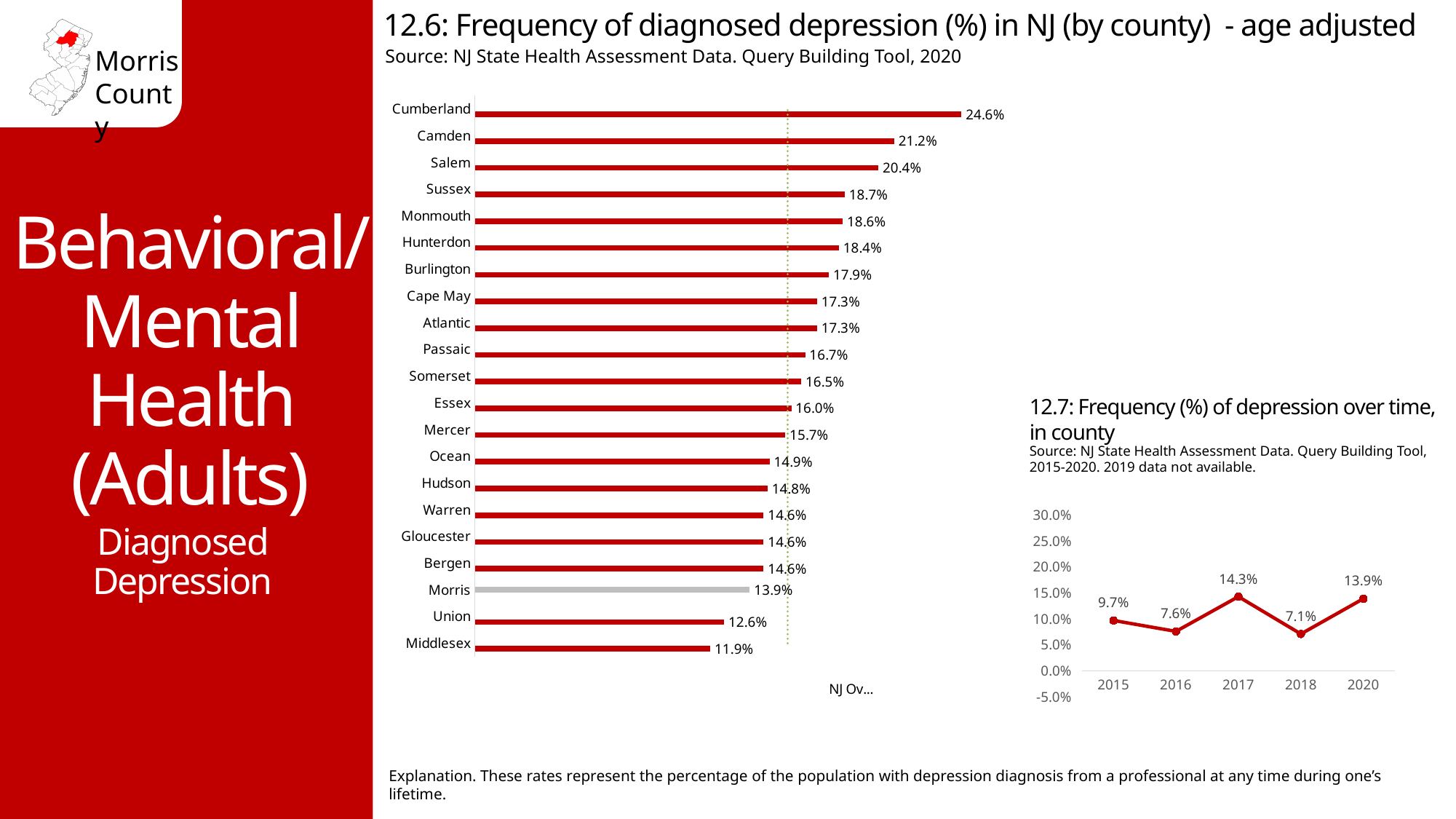
In the chart '12.7: Frequency (%) of depression over time, in county', what is the difference between 2020 and 2018? 6.8% In the chart '12.7: Frequency (%) of depression over time, in county', what is the value for 2017? 14.3% In the chart '12.6: Frequency of diagnosed depression (%) in NJ (by county) - age adjusted', what is the difference between Cumberland and Middlesex? 12.7% In the chart '12.6: Frequency of diagnosed depression (%) in NJ (by county) - age adjusted', what is the value for Morris? 13.9% In the chart '12.6: Frequency of diagnosed depression (%) in NJ (by county) - age adjusted', what is the value for Union? 12.6% In the chart '12.6: Frequency of diagnosed depression (%) in NJ (by county) - age adjusted', which is larger, Camden or Salem? Camden In the chart '12.6: Frequency of diagnosed depression (%) in NJ (by county) - age adjusted', which county has the highest value? Cumberland In the chart '12.7: Frequency (%) of depression over time, in county', which year has the lowest value? 2018 What kind of chart is '12.7: Frequency (%) of depression over time, in county'? Line chart What kind of chart is '12.6: Frequency of diagnosed depression (%) in NJ (by county) - age adjusted'? Bar chart In the chart '12.6: Frequency of diagnosed depression (%) in NJ (by county) - age adjusted', which county has the lowest value? Middlesex In the chart '12.6: Frequency of diagnosed depression (%) in NJ (by county) - age adjusted', how many counties are shown? 21